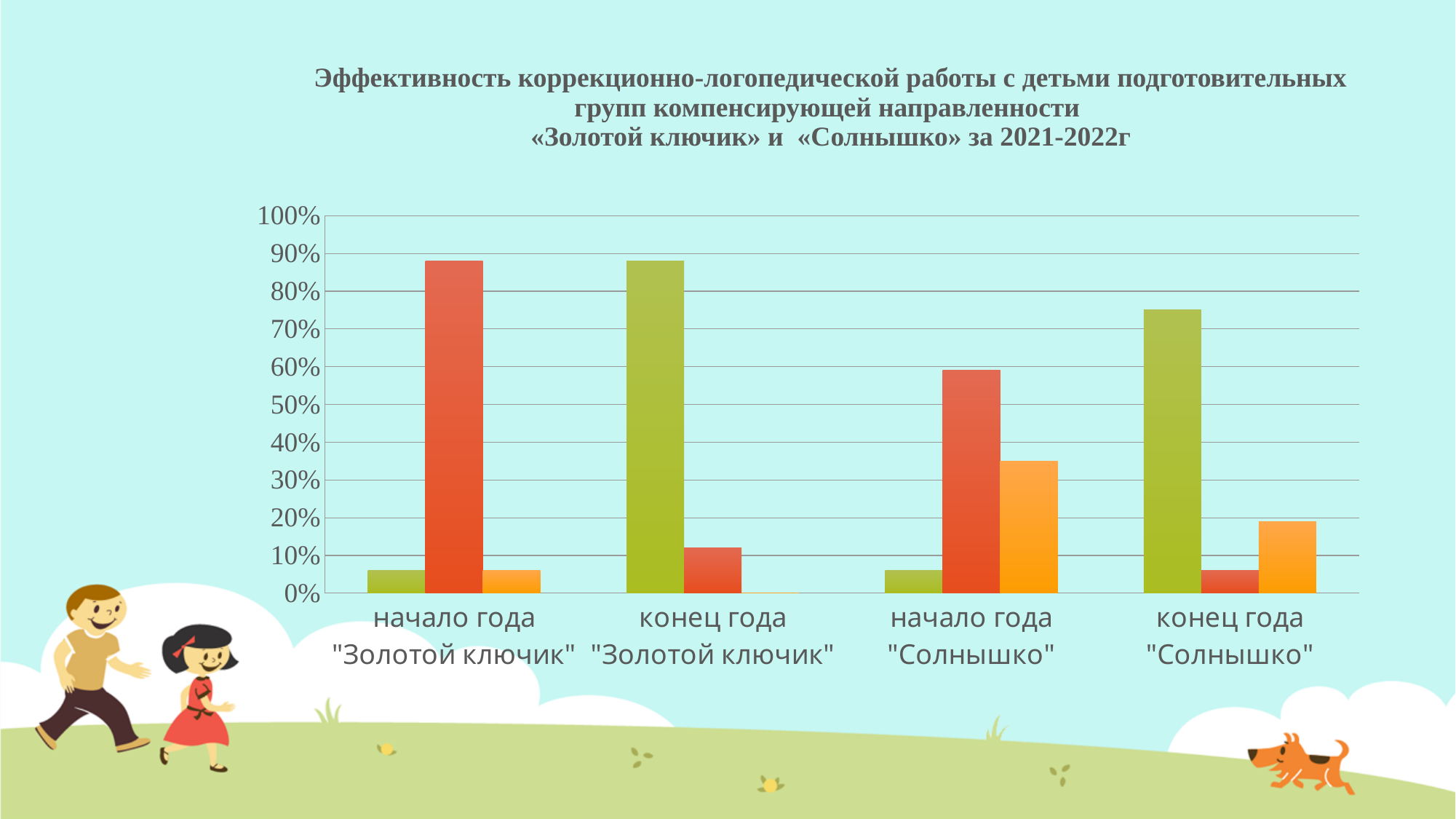
Is the red bar for начало года "Золотой ключик" greater or less than 80%? greater Is the green bar for конец года "Солнышко" greater or less than 70%? greater What kind of chart is shown on the slide? bar chart Is the orange bar for начало года "Солнышко" greater or less than 30%? greater How many categories are shown on the x axis of the chart? 4 What period does the chart title say the data covers? 2021-2022г Which category has the tallest green bar? конец года "Золотой ключик" Which is larger: the green bar for конец года "Золотой ключик" or the green bar for конец года "Солнышко"? конец года "Золотой ключик" Which category has the tallest red bar? начало года "Золотой ключик"